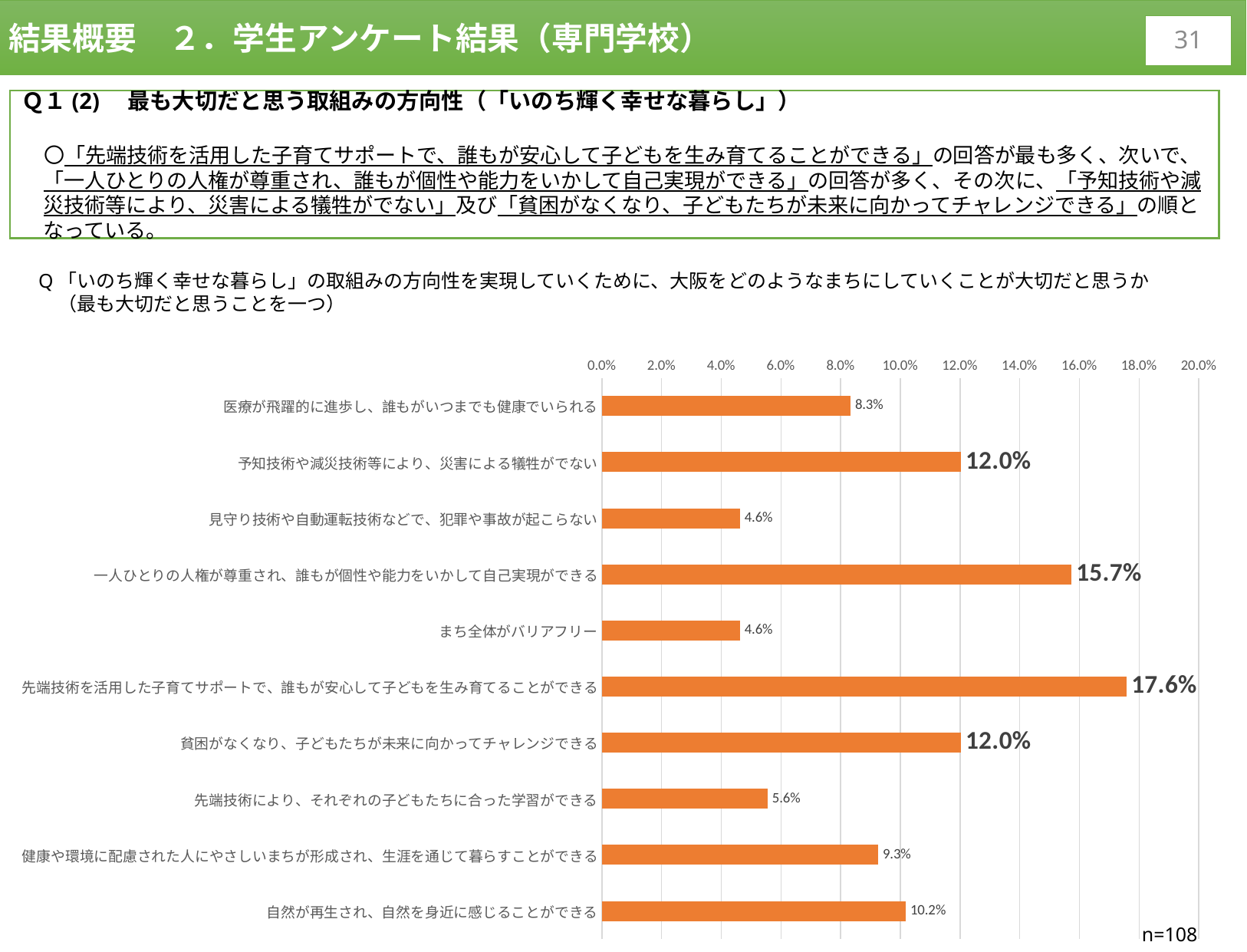
What is the sample size (n) shown on the chart? n=108 Which category has the highest percentage in the chart? 先端技術を活用した子育てサポートで、誰もが安心して子どもを生み育てることができる Which is larger: the value for 「医療が飛躍的に進歩し、誰もがいつまでも健康でいられる」 or for 「健康や環境に配慮された人にやさしいまちが形成され、生涯を通じて暮らすことができる」? 健康や環境に配慮された人にやさしいまちが形成され、生涯を通じて暮らすことができる What percentage of respondents chose 「先端技術を活用した子育てサポートで、誰もが安心して子どもを生み育てることができる」? 17.6% What is the difference between the values for 「先端技術を活用した子育てサポートで、誰もが安心して子どもを生み育てることができる」 and 「一人ひとりの人権が尊重され、誰もが個性や能力をいかして自己実現ができる」? 1.9% What is the value shown for 「まち全体がバリアフリー」? 4.6% How many categories are shown in the bar chart? 10 Is the value for 「先端技術により、それぞれの子どもたちに合った学習ができる」 greater or less than 6.0%? less What is the maximum value shown on the chart's percentage axis? 20.0% What is the lowest percentage value shown in the chart? 4.6% What percentage is shown for 「自然が再生され、自然を身近に感じることができる」? 10.2% What type of chart is shown on the slide? bar chart